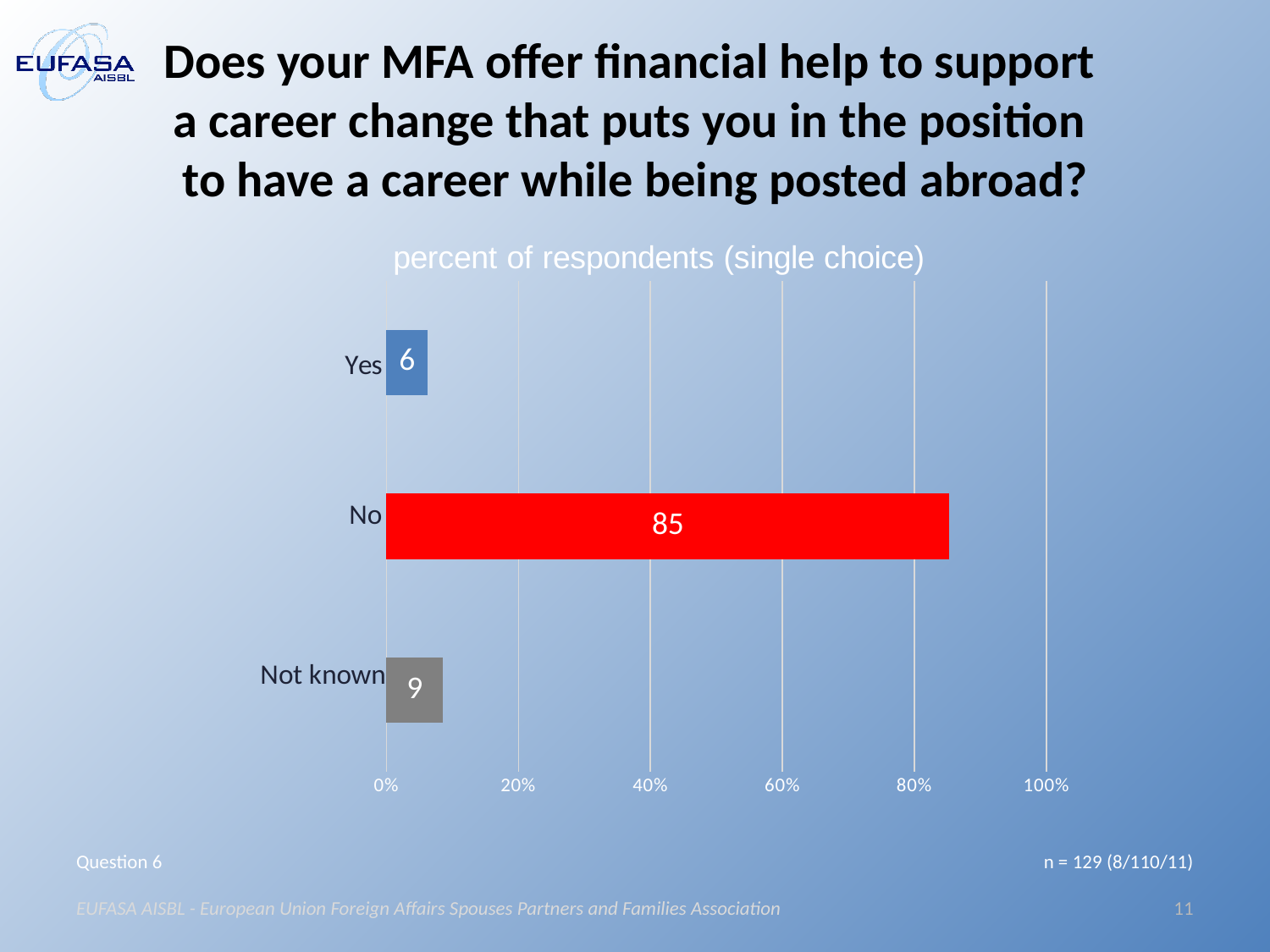
Which category has the highest value? No What kind of chart is shown on the slide? bar chart What is the value for "Not known"? 9 What is the difference between the values for "No" and "Not known"? 76 Which is larger, the value for "Not known" or the value for "Yes"? Not known Which category has the lowest value? Yes What is the value for "Yes"? 6 Is the value for "No" greater or less than 80%? greater What is the title of the chart? percent of respondents (single choice) How many categories are shown in the chart? 3 What is the value for "No"? 85 What is the difference between the values for "Not known" and "Yes"? 3